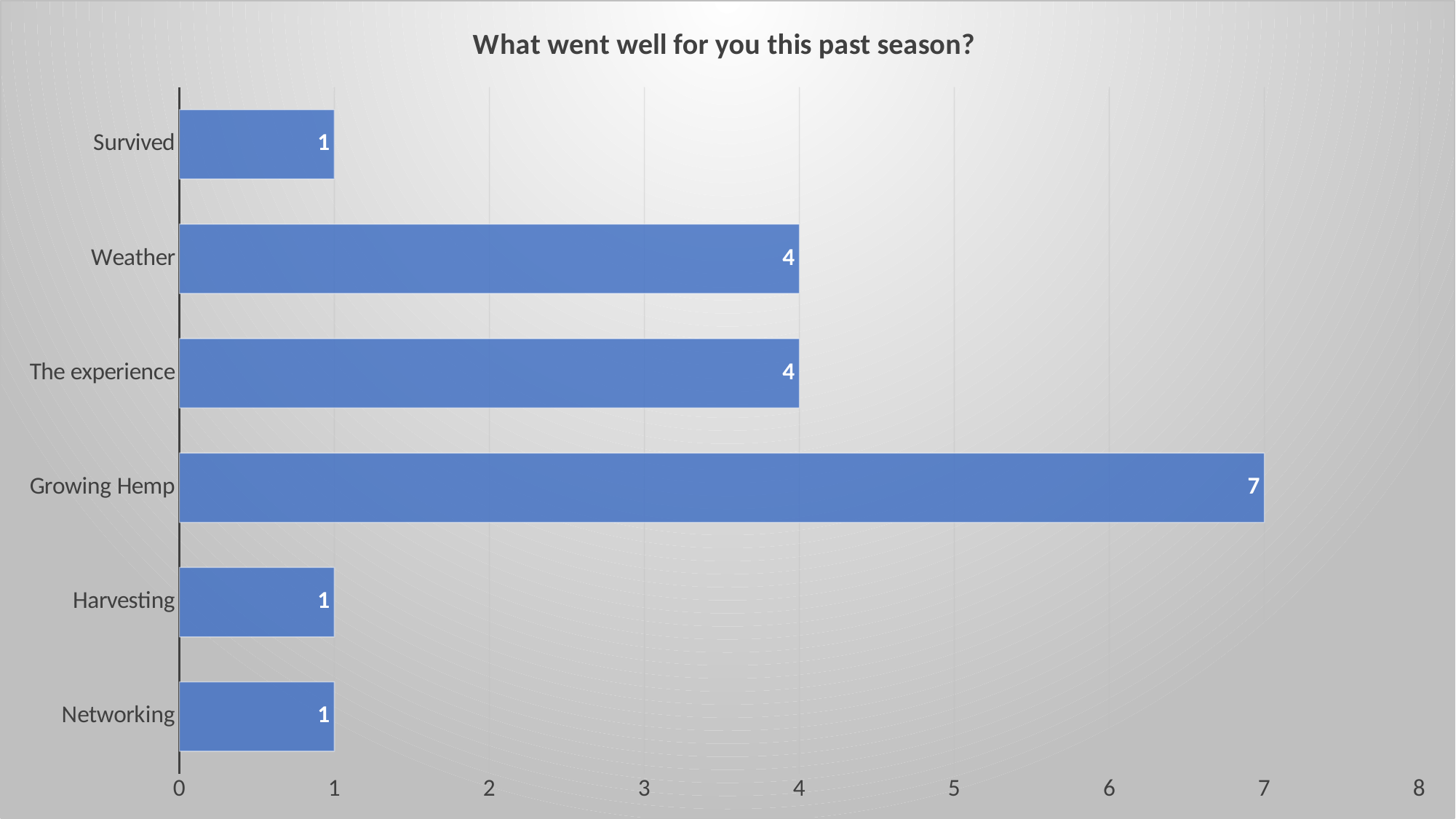
What is the title of the chart? What went well for you this past season? Is the value for Growing Hemp greater or less than 5? greater How many categories have a value of 1? 3 Which category has the highest value? Growing Hemp What is the value for Weather? 4 What is the value for Growing Hemp? 7 How many categories are shown in the chart? 6 What is the value for Networking? 1 What is the difference between the values for Weather and Survived? 3 What kind of chart is shown on the slide? bar chart What is the difference between the values for Growing Hemp and The experience? 3 Which is larger, the value for Weather or the value for Harvesting? Weather